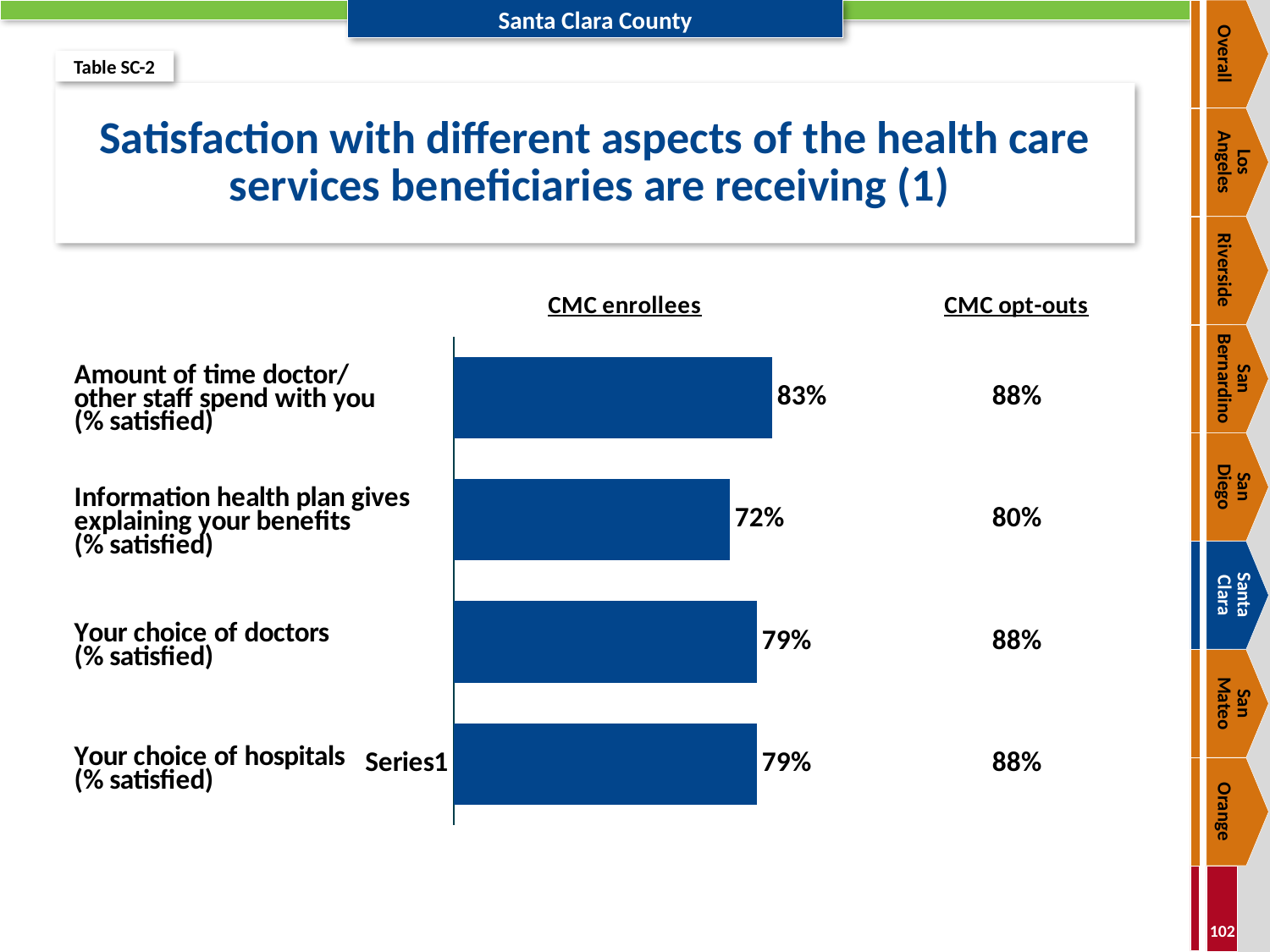
What is the CMC enrollees value for 'Your choice of doctors (% satisfied)'? 79% Which category has the highest CMC enrollees value? Amount of time doctor/other staff spend with you (% satisfied) What is the CMC opt-outs value for 'Information health plan gives explaining your benefits (% satisfied)'? 80% What kind of chart is shown on the slide? bar chart For 'Your choice of doctors (% satisfied)', what is the difference between the CMC opt-outs value and the CMC enrollees value? 9% What is the title of the chart on the slide? Satisfaction with different aspects of the health care services beneficiaries are receiving (1) Which is larger for 'Your choice of hospitals (% satisfied)': the CMC enrollees value or the CMC opt-outs value? CMC opt-outs What is the CMC enrollees value for 'Information health plan gives explaining your benefits (% satisfied)'? 72% How many categories are plotted in the bar chart? 4 What is the difference between the CMC enrollees values for 'Amount of time doctor/other staff spend with you' and 'Information health plan gives explaining your benefits'? 11% What is the CMC enrollees value for 'Amount of time doctor/other staff spend with you (% satisfied)'? 83% Which category has the lowest CMC enrollees value? Information health plan gives explaining your benefits (% satisfied)